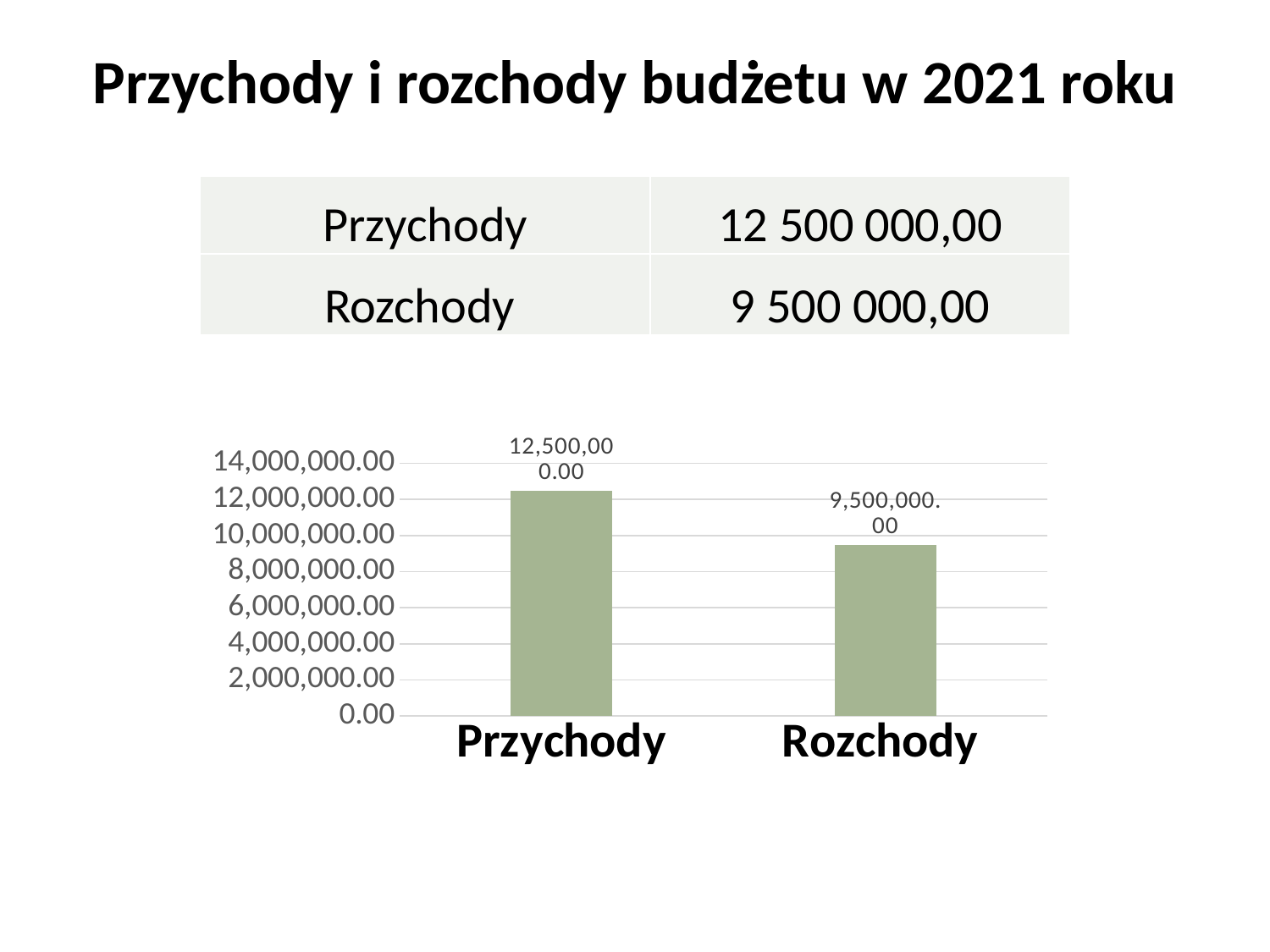
What is the highest tick value shown on the vertical axis? 14,000,000.00 What is the value of the Przychody bar? 12,500,000.00 Which category has the lower bar? Rozchody Is the value for Przychody greater or less than 10,000,000.00? greater Which category has the higher bar? Przychody Is the value for Rozchody greater or less than 10,000,000.00? less What is the difference between the Przychody and Rozchody values? 3,000,000.00 Do the bar values rise or fall from Przychody to Rozchody? fall What is the title of the slide containing the chart? Przychody i rozchody budżetu w 2021 roku What is the value of the Rozchody bar? 9,500,000.00 How many categories are shown on the x axis of the chart? 2 What kind of chart is shown on the slide? bar chart